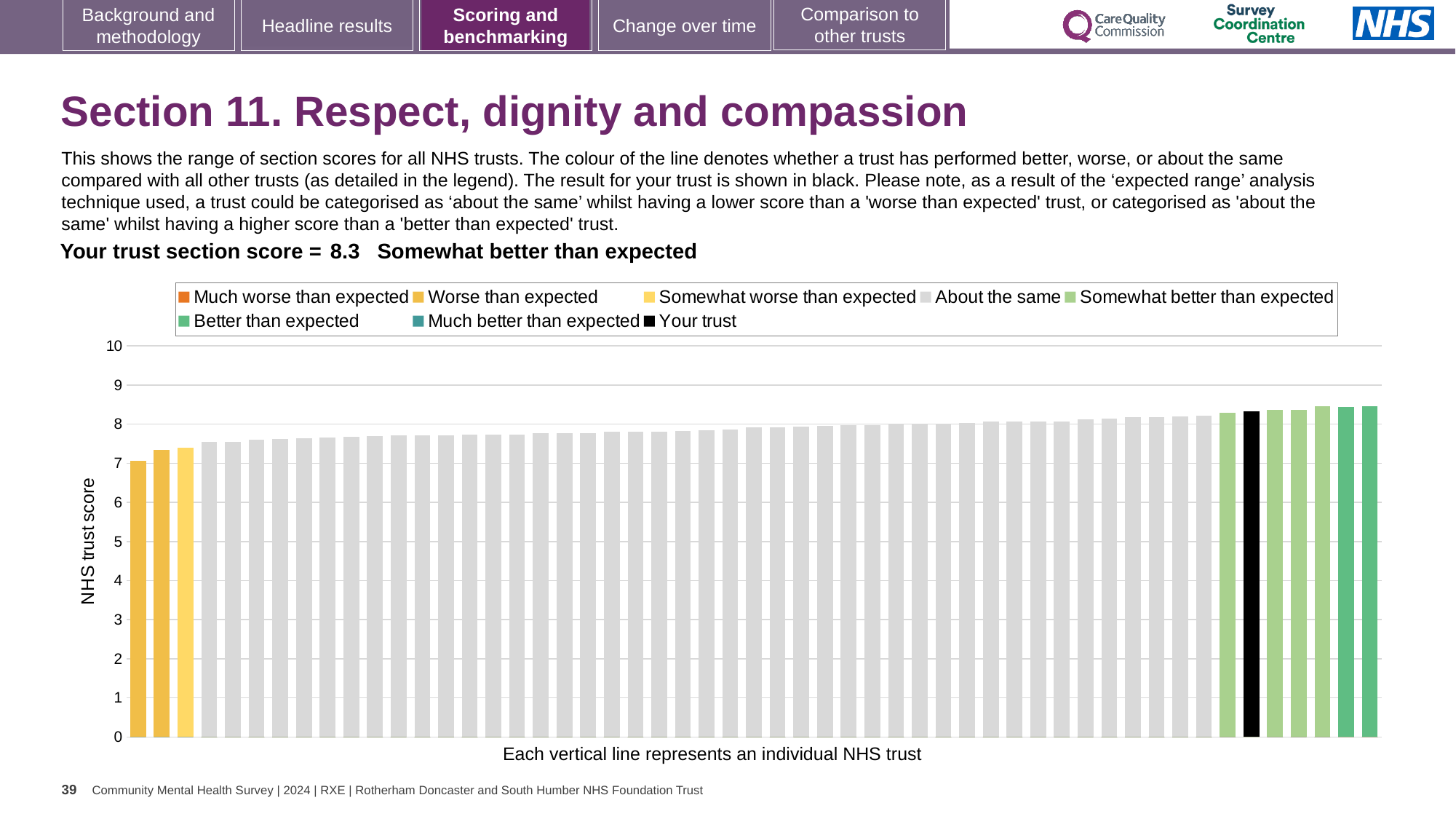
What is the label on the vertical axis of the chart? NHS trust score Is the value for the 'Your trust' bar greater or less than 8? greater Is the value for the highest bar in the chart greater or less than 9? less Is the value for the lowest bar in the chart greater or less than 8? less How many bars are coloured in the yellow/orange 'worse than expected' shades? 3 How many entries does the chart legend list? 8 What colour is the bar representing your trust? black Do the bar values rise or fall from left to right along the x axis? rise Which is larger: the 'Your trust' bar or the leftmost bar? Your trust What kind of chart is shown on the slide? bar chart What is the section score for your trust shown on the slide? 8.3